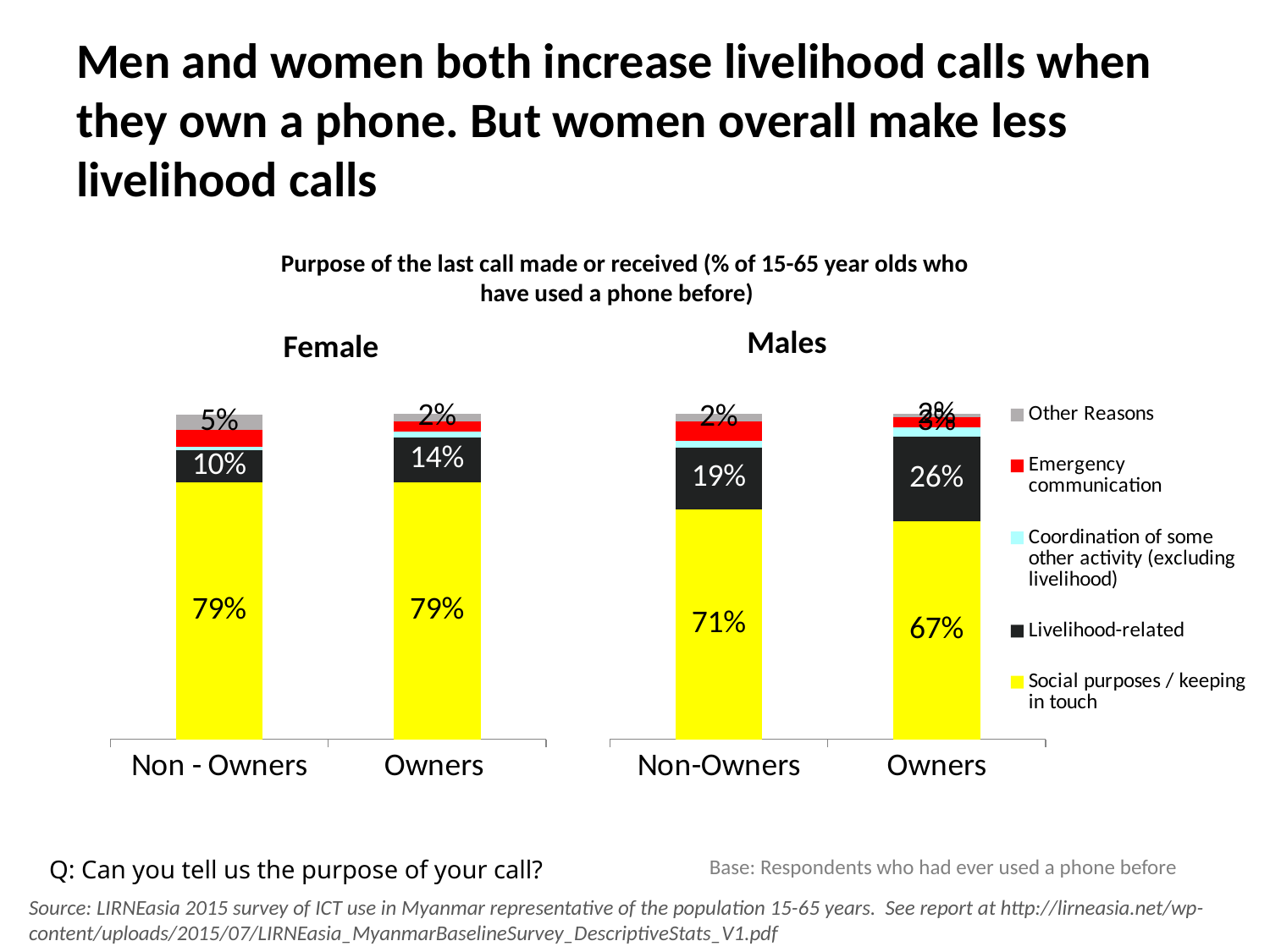
What kind of chart is used for the Female and Males data? Stacked bar chart Which is larger: the Livelihood-related share for Female Owners or for Male Owners? Male Owners In the Males chart, what is the Social purposes / keeping in touch value for Owners? 67% In the Males chart, which category has the higher Social purposes / keeping in touch share, Non-Owners or Owners? Non-Owners In the Female chart, what is the value for Social purposes / keeping in touch among Non-Owners? 79% In the Males chart, what is the Livelihood-related value for Owners? 26% In the Males chart, what is the difference in Livelihood-related share between Owners and Non-Owners? 7% In the Female chart, what is the difference in Livelihood-related share between Owners and Non-Owners? 4% How many series does the legend list? 5 In the Males chart, what is the Livelihood-related value for Non-Owners? 19% In the Female chart, what is the Livelihood-related value for Owners? 14% How many categories are shown on the x axis of the Female chart? 2